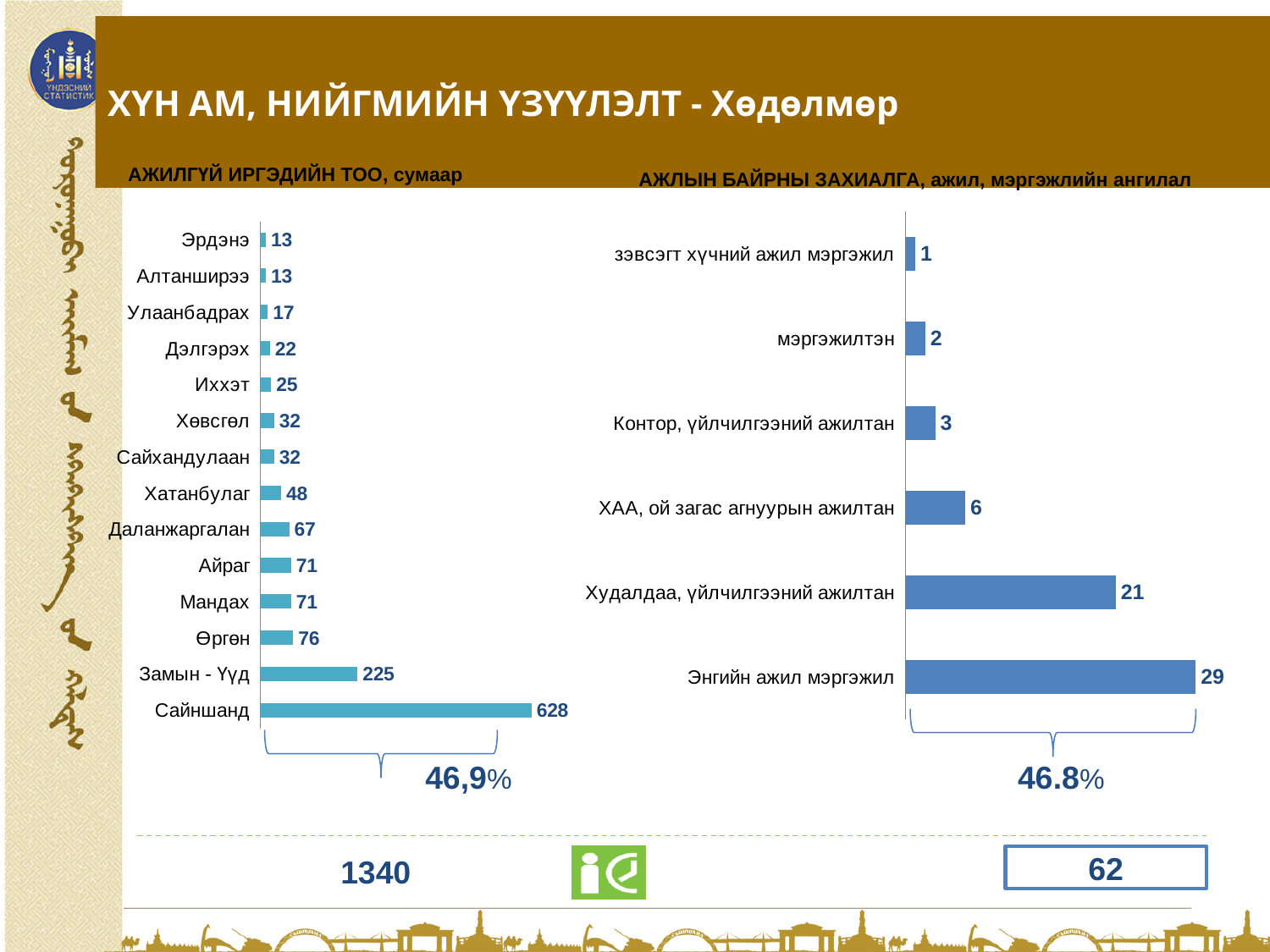
In the left chart (АЖИЛГҮЙ ИРГЭДИЙН ТОО, сумаар), which soum has the highest value? Сайншанд In the left chart (АЖИЛГҮЙ ИРГЭДИЙН ТОО, сумаар), which is larger, the value for Хатанбулаг or the value for Даланжаргалан? Даланжаргалан What type of chart is the left chart (АЖИЛГҮЙ ИРГЭДИЙН ТОО, сумаар)? Bar chart In the right chart (АЖЛЫН БАЙРНЫ ЗАХИАЛГА), what is the value for Худалдаа, үйлчилгээний ажилтан? 21 How many soums are shown in the left chart (АЖИЛГҮЙ ИРГЭДИЙН ТОО, сумаар)? 14 In the left chart (АЖИЛГҮЙ ИРГЭДИЙН ТОО, сумаар), what is the value for Сайншанд? 628 In the right chart (АЖЛЫН БАЙРНЫ ЗАХИАЛГА), what is the value for Энгийн ажил мэргэжил? 29 In the right chart (АЖЛЫН БАЙРНЫ ЗАХИАЛГА), which category has the lowest value? зэвсэгт хүчний ажил мэргэжил In the left chart (АЖИЛГҮЙ ИРГЭДИЙН ТОО, сумаар), what is the difference between the values for Сайншанд and Замын - Үүд? 403 In the right chart (АЖЛЫН БАЙРНЫ ЗАХИАЛГА), what is the difference between the values for Энгийн ажил мэргэжил and ХАА, ой загас агнуурын ажилтан? 23 How many categories are shown in the right chart (АЖЛЫН БАЙРНЫ ЗАХИАЛГА)? 6 In the left chart (АЖИЛГҮЙ ИРГЭДИЙН ТОО, сумаар), what is the value for Замын - Үүд? 225